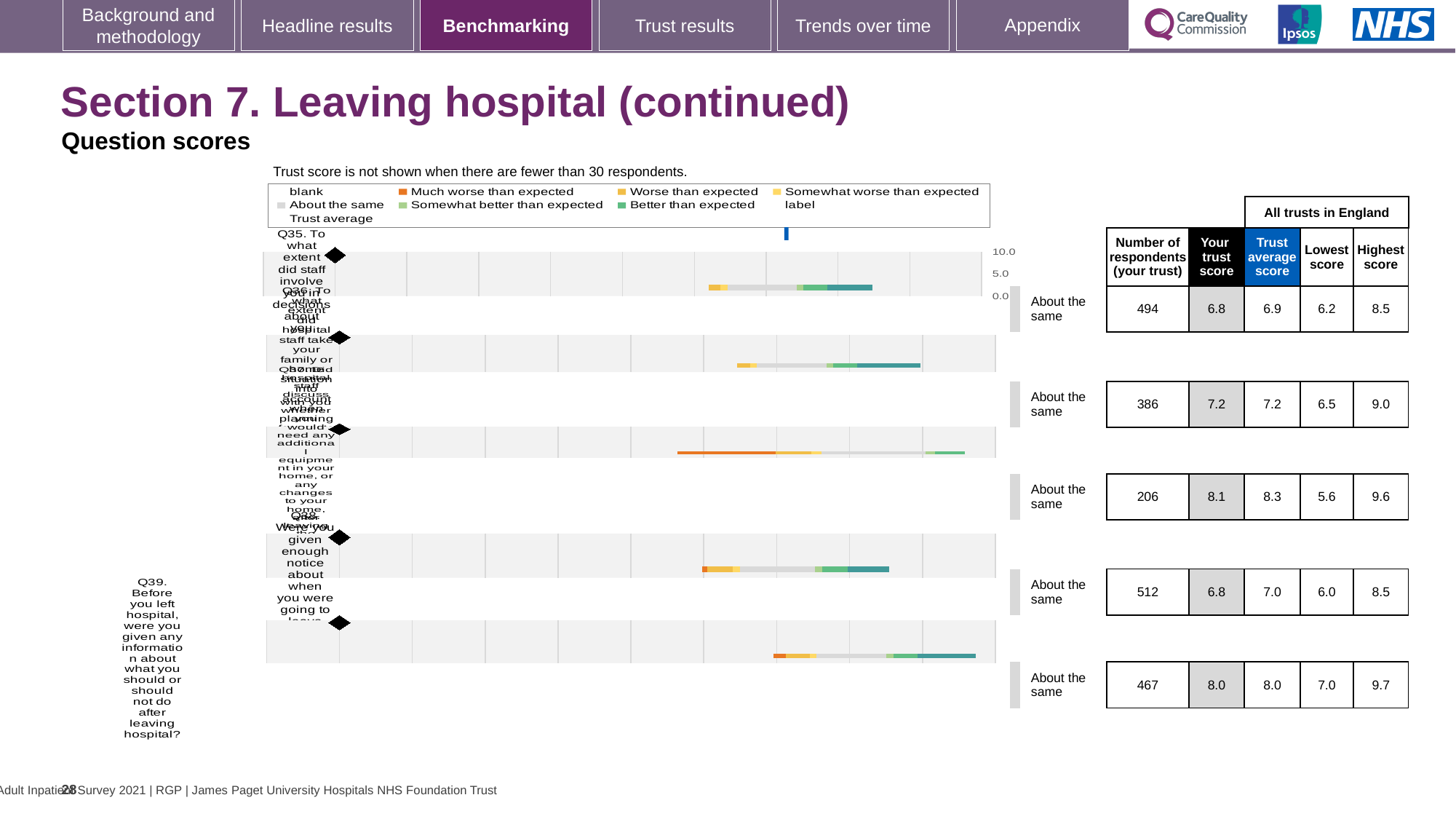
How many respondents from your trust answered Q35 according to the table? 494 How many question rows are shown in the table on this slide? 5 What is the smallest value in the 'Lowest score' column of the table? 5.6 What benchmark category is shown next to each question on this slide? About the same What is the trust average score for Q35? 6.9 What kind of chart is used to show the question scores on this slide? bar chart What is the highest 'Your trust score' value shown in the table? 8.1 What is the highest score across all trusts in England for Q39? 9.7 For Q35, which is larger: your trust score or the trust average score? Trust average score What is the difference between the highest score and the lowest score for Q39? 2.7 How many respondents from your trust answered Q39 (information about what to do after leaving hospital)? 467 What is the 'Your trust score' for Q35 in the table? 6.8